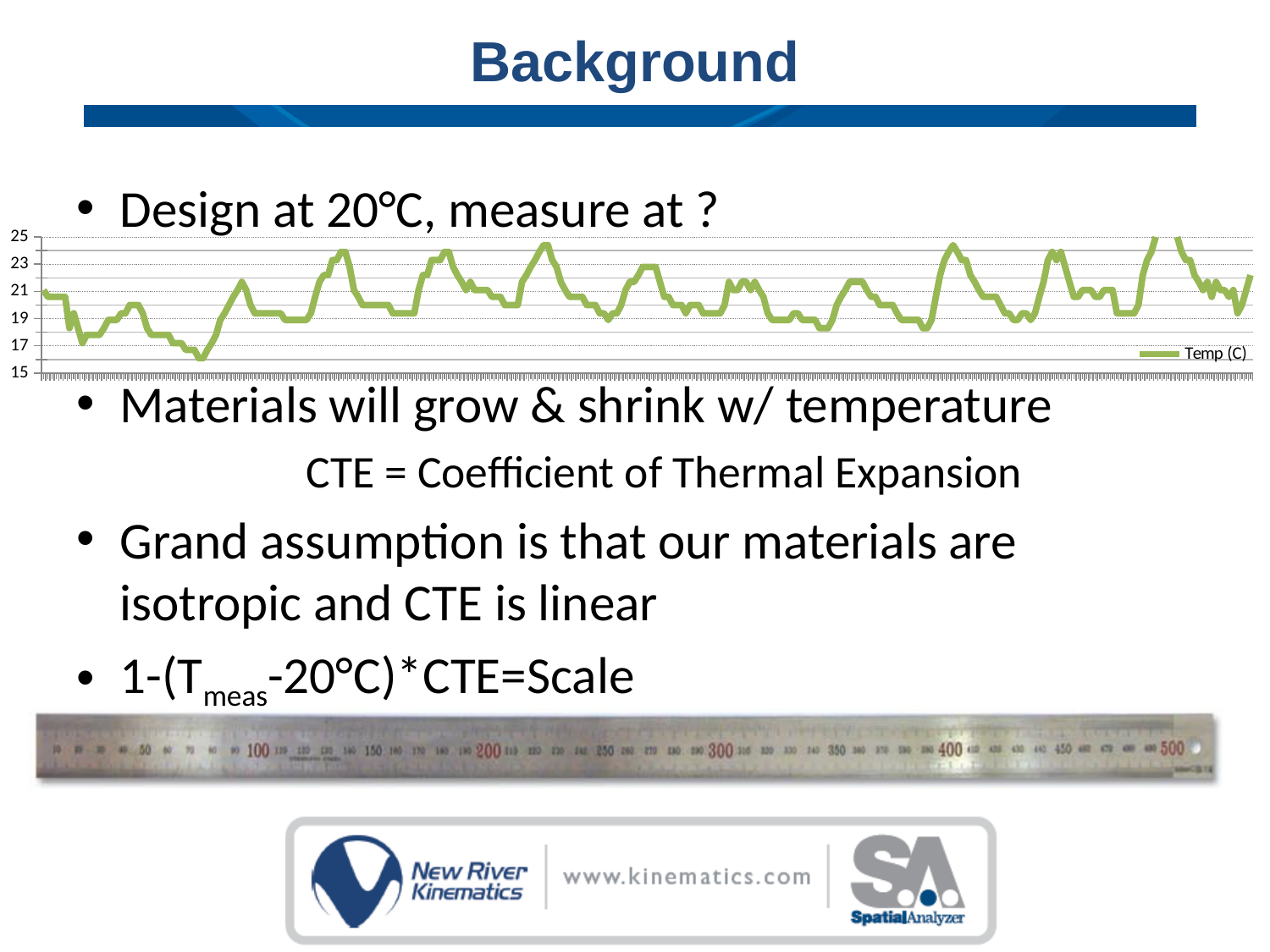
What kind of chart is shown on the slide? line chart Does the Temp (C) line show a steady rise, a steady fall, or repeated fluctuation along the x axis? repeated fluctuation Is the highest point of the Temp (C) line greater or less than 23? greater What is the name of the series shown in the chart's legend? Temp (C) What is the lowest value labelled on the chart's vertical axis? 15 How many series does the chart's legend list? 1 Is the lowest point of the Temp (C) line greater or less than 17? less